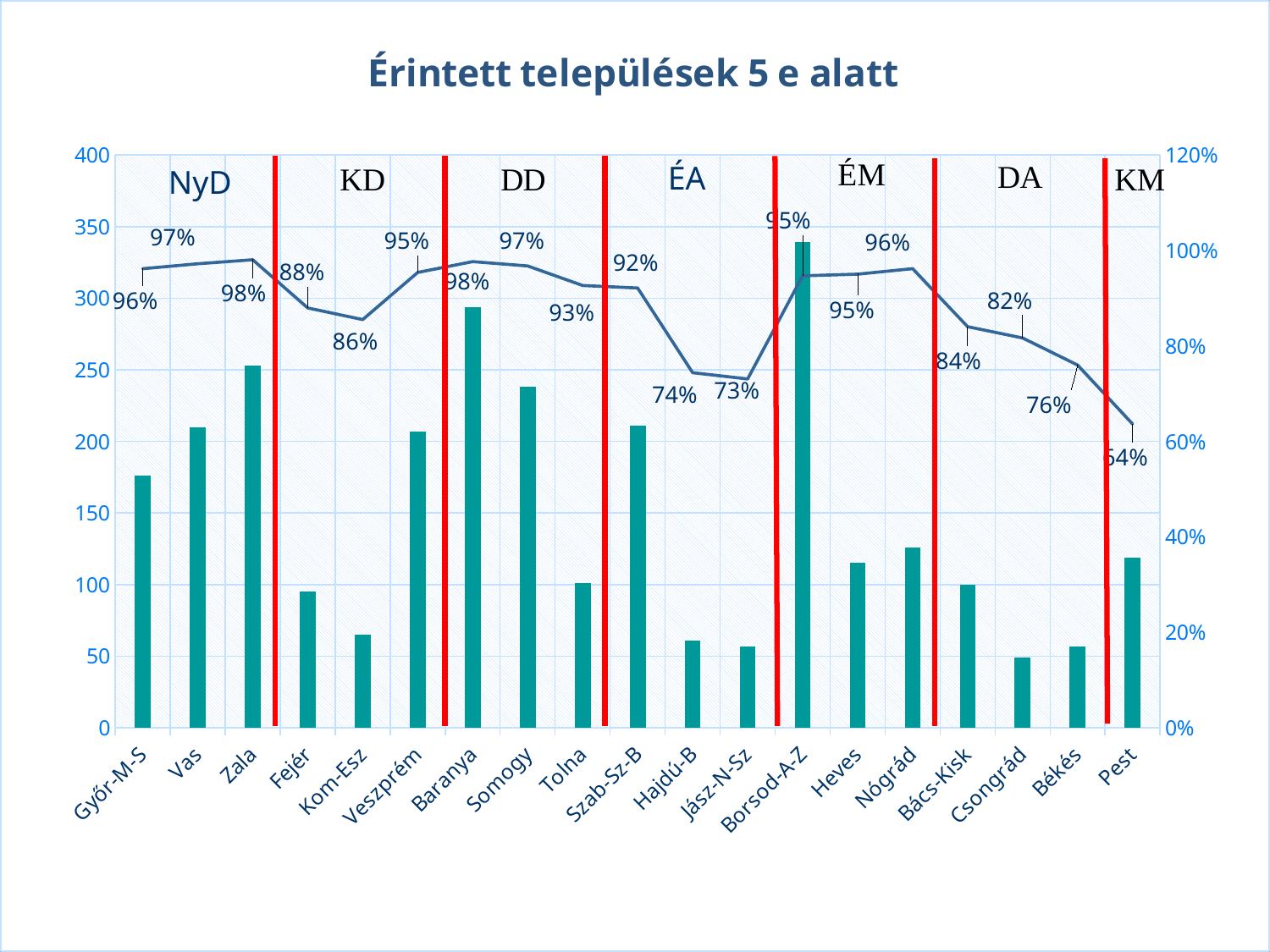
What percentage is shown for Veszprém on the line? 95% Which category has the lowest percentage on the line? Pest What is the title of the chart? Érintett települések 5 e alatt Which category has the tallest bar? Borsod-A-Z What percentage is shown for Jász-N-Sz on the line? 73% How many categories are shown on the x axis? 19 What is the difference between the percentage for Zala and the percentage for Pest? 34% Is the bar value for Borsod-A-Z greater or less than 300? greater Which has the taller bar, Borsod-A-Z or Heves? Borsod-A-Z What percentage is shown for Pest on the line? 64% Is the bar value for Vas greater or less than 200? greater